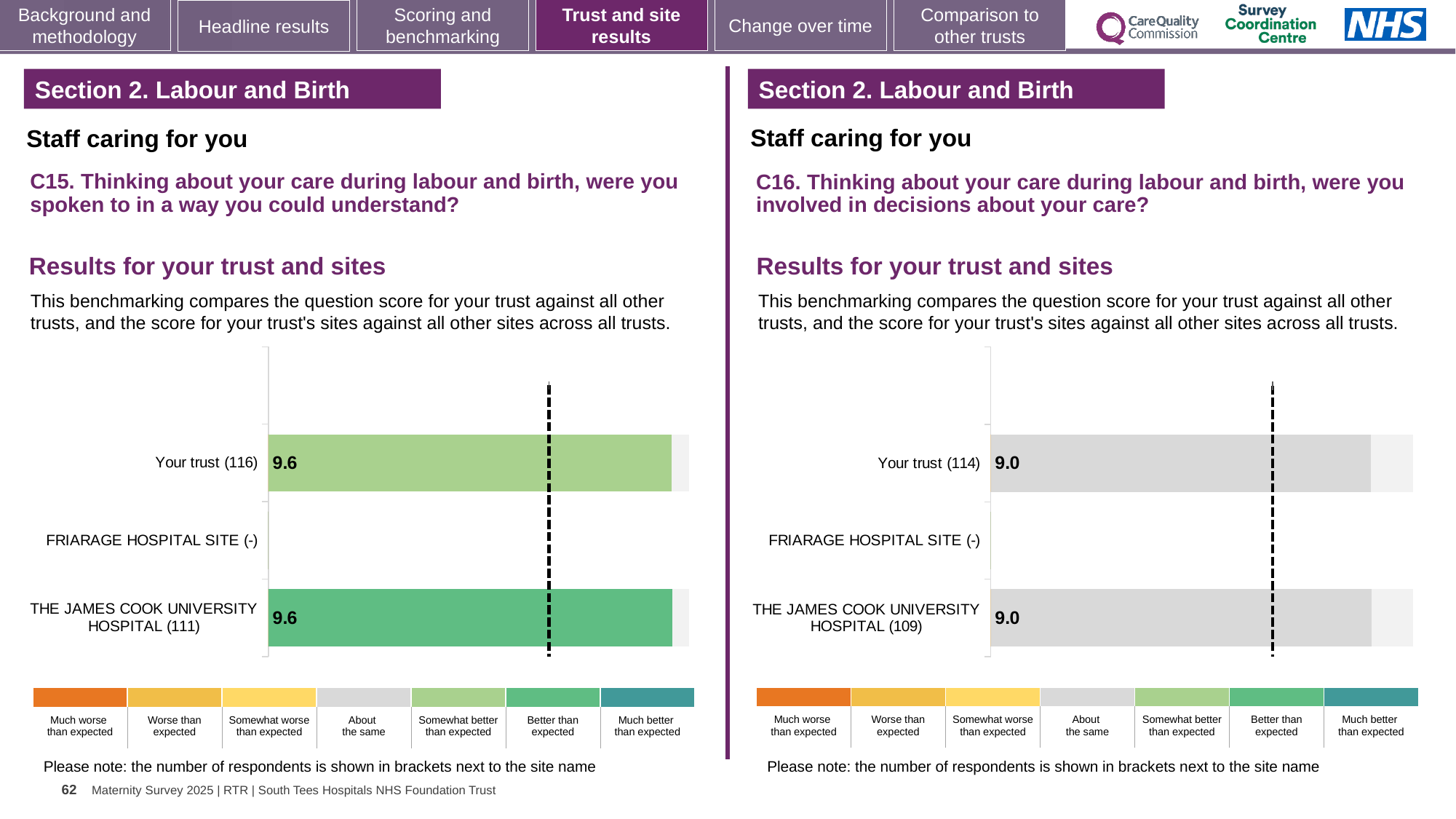
In the C16 chart on the right, what is the score for Your trust? 9.0 How many site/trust categories are listed on the y axis of the C15 chart on the left? 3 In the C15 chart on the left, what is the score for The James Cook University Hospital? 9.6 In the C16 chart on the right, which benchmark category does the grey colour of the Your trust bar correspond to in the key? About the same How many site/trust categories are listed on the y axis of the C16 chart on the right? 3 What kind of chart is used for the C15 results on the left? Bar chart How many benchmark categories does the colour key below the C16 chart on the right list? 7 In the C15 chart on the left, what is the difference between the score for Your trust and the score for The James Cook University Hospital? 0.0 In the C15 chart on the left, what is the score for Your trust? 9.6 In the C16 chart on the right, what is the score for The James Cook University Hospital? 9.0 In the C15 chart on the left, how many respondents are shown in brackets for Your trust? 116 In the C16 chart on the right, how many respondents are shown in brackets for The James Cook University Hospital? 109